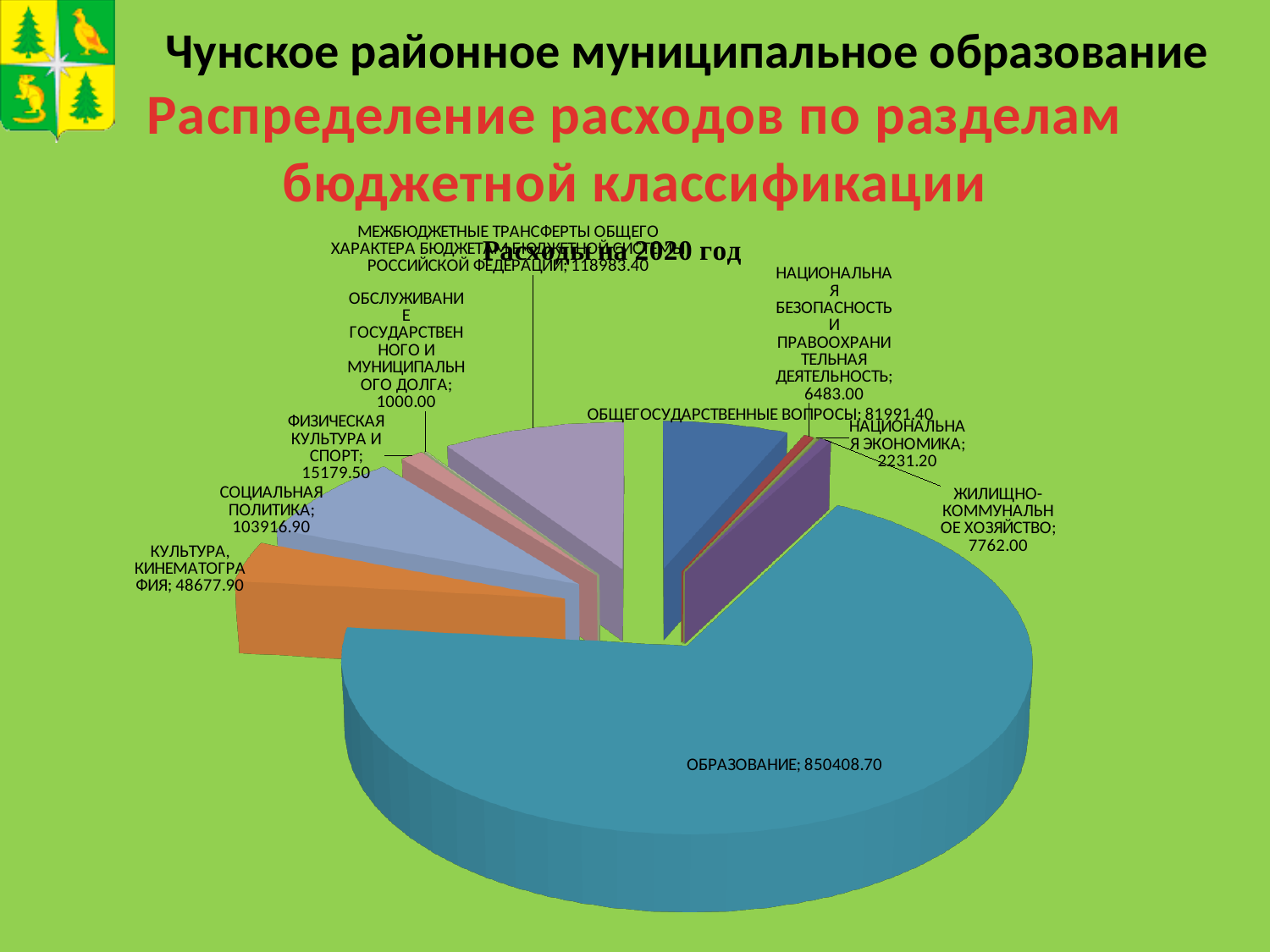
What is the value for СОЦИАЛЬНАЯ ПОЛИТИКА? 103916.90 How many categories (slices) does the pie chart have? 10 What is the difference between the values for ЖИЛИЩНО-КОММУНАЛЬНОЕ ХОЗЯЙСТВО and НАЦИОНАЛЬНАЯ БЕЗОПАСНОСТЬ И ПРАВООХРАНИТЕЛЬНАЯ ДЕЯТЕЛЬНОСТЬ? 1279.00 What is the value for ФИЗИЧЕСКАЯ КУЛЬТУРА И СПОРТ? 15179.50 What type of chart is shown on the slide? Pie chart What is the difference between the values for СОЦИАЛЬНАЯ ПОЛИТИКА and ОБЩЕГОСУДАРСТВЕННЫЕ ВОПРОСЫ? 21925.50 Which category has the largest value? ОБРАЗОВАНИЕ What is the value for ЖИЛИЩНО-КОММУНАЛЬНОЕ ХОЗЯЙСТВО? 7762.00 Which category has the smallest value? ОБСЛУЖИВАНИЕ ГОСУДАРСТВЕННОГО И МУНИЦИПАЛЬНОГО ДОЛГА What is the value for ОБРАЗОВАНИЕ? 850408.70 Which is larger: the value for КУЛЬТУРА, КИНЕМАТОГРАФИЯ or the value for ОБЩЕГОСУДАРСТВЕННЫЕ ВОПРОСЫ? ОБЩЕГОСУДАРСТВЕННЫЕ ВОПРОСЫ What is the title of the chart? Расходы на 2020 год